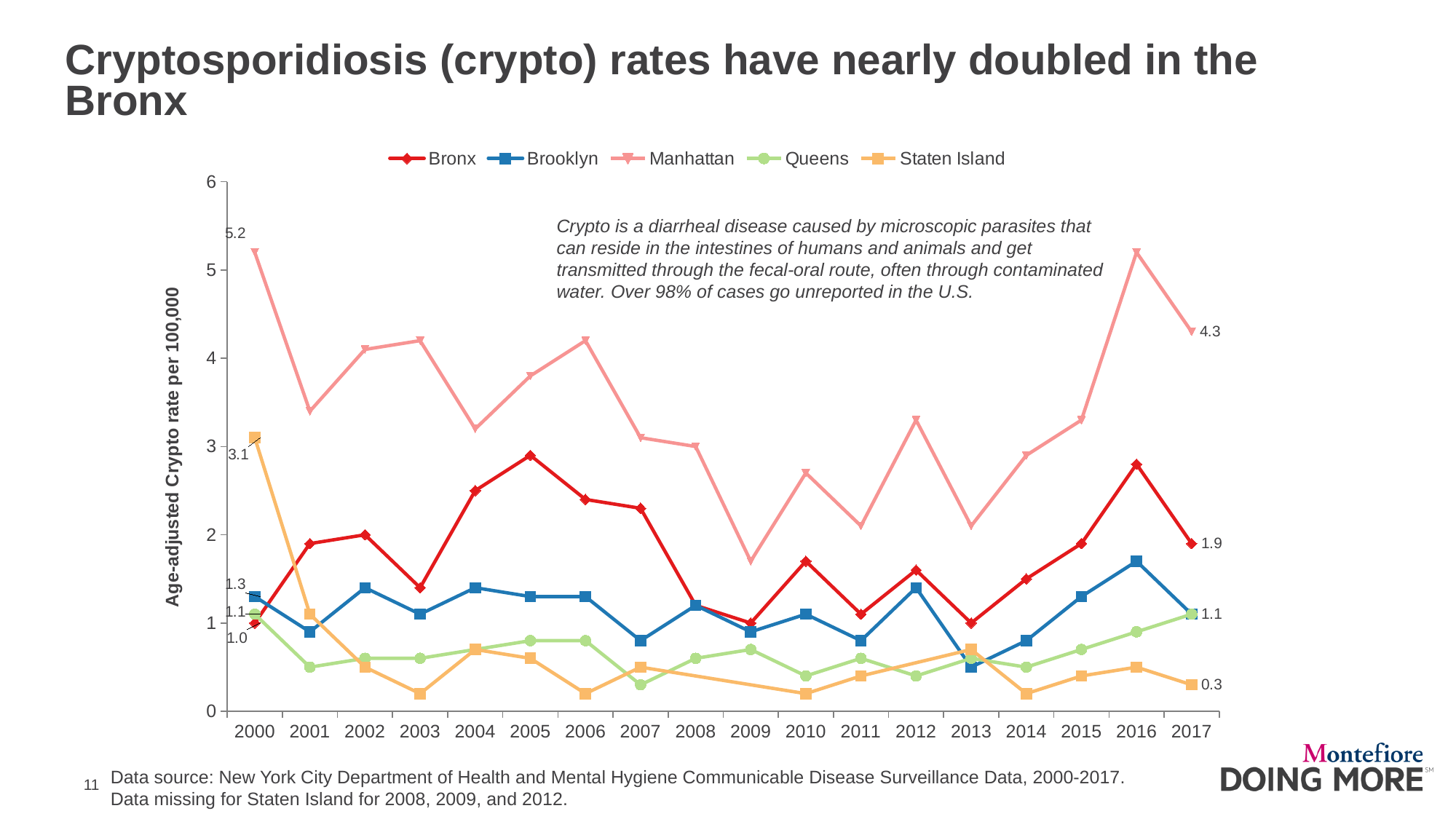
What type of chart is shown on the slide? Line chart By how much did the Bronx crypto rate increase from 2000 to 2017? 0.9 What was the Bronx crypto rate in 2017? 1.9 What is the label of the y axis? Age-adjusted Crypto rate per 100,000 Which borough had the lowest crypto rate in 2017? Staten Island Which had the higher crypto rate in 2017, the Bronx or Brooklyn? Bronx Which borough had the highest crypto rate in 2000? Manhattan What was the Staten Island crypto rate in 2017? 0.3 How many years are plotted along the x axis? 18 Is the Manhattan crypto rate in 2016 greater or less than 5? greater How many series does the legend list? 5 What was the Manhattan crypto rate in 2000? 5.2